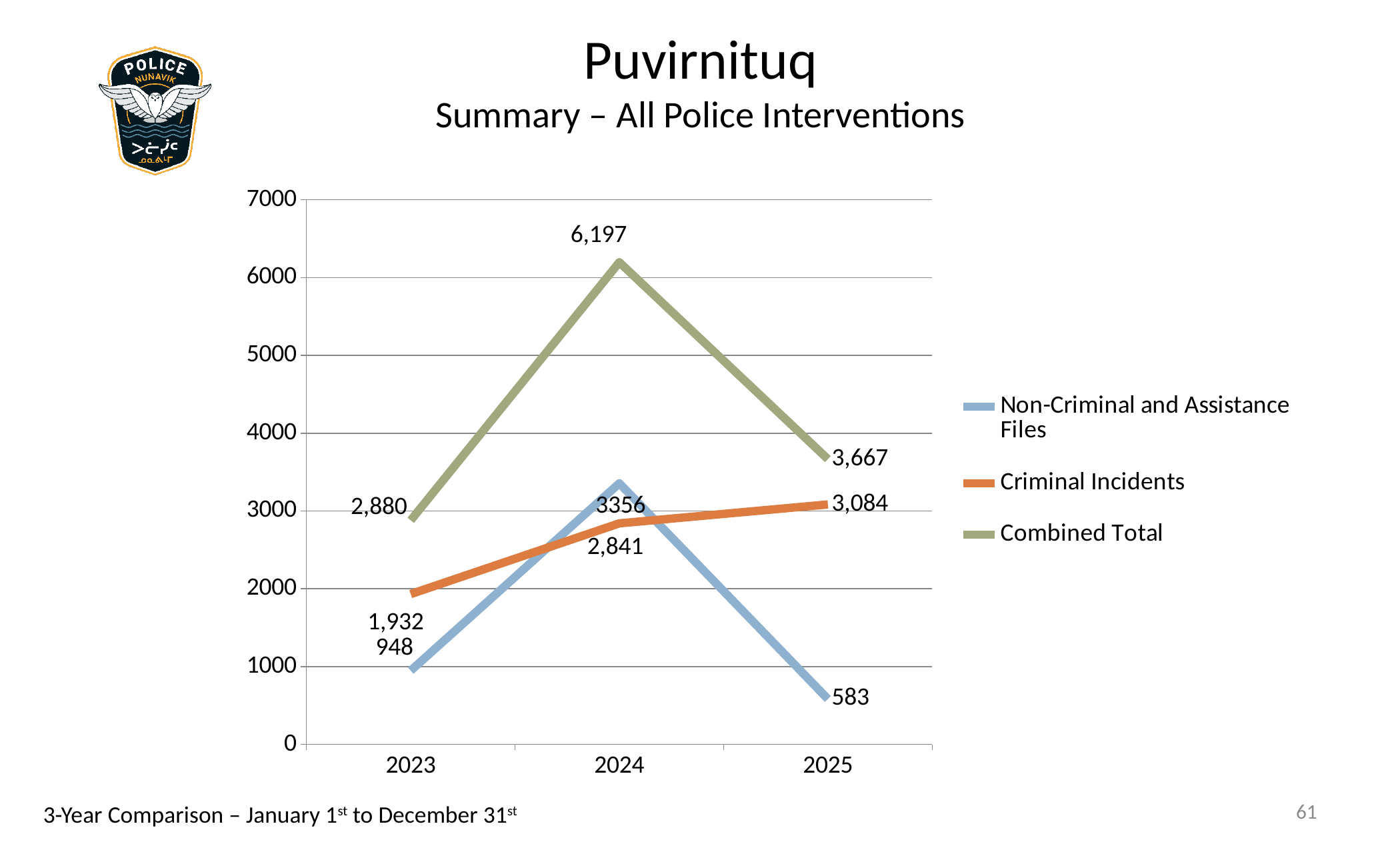
How many series does the legend list? 3 Which series is drawn in orange? Criminal Incidents How many years are shown on the x axis? 3 What is the value for Non-Criminal and Assistance Files in 2025? 583 In which year is the value for Non-Criminal and Assistance Files lowest? 2025 What is the Combined Total value for 2024? 6,197 Do the Criminal Incidents values rise or fall from 2023 to 2025? rise Which is larger in 2024: Non-Criminal and Assistance Files or Criminal Incidents? Non-Criminal and Assistance Files In which year is the Combined Total highest? 2024 What is the difference between the Combined Total in 2024 and in 2025? 2,530 What is the value for Criminal Incidents in 2023? 1,932 What type of chart is shown on the slide? line chart